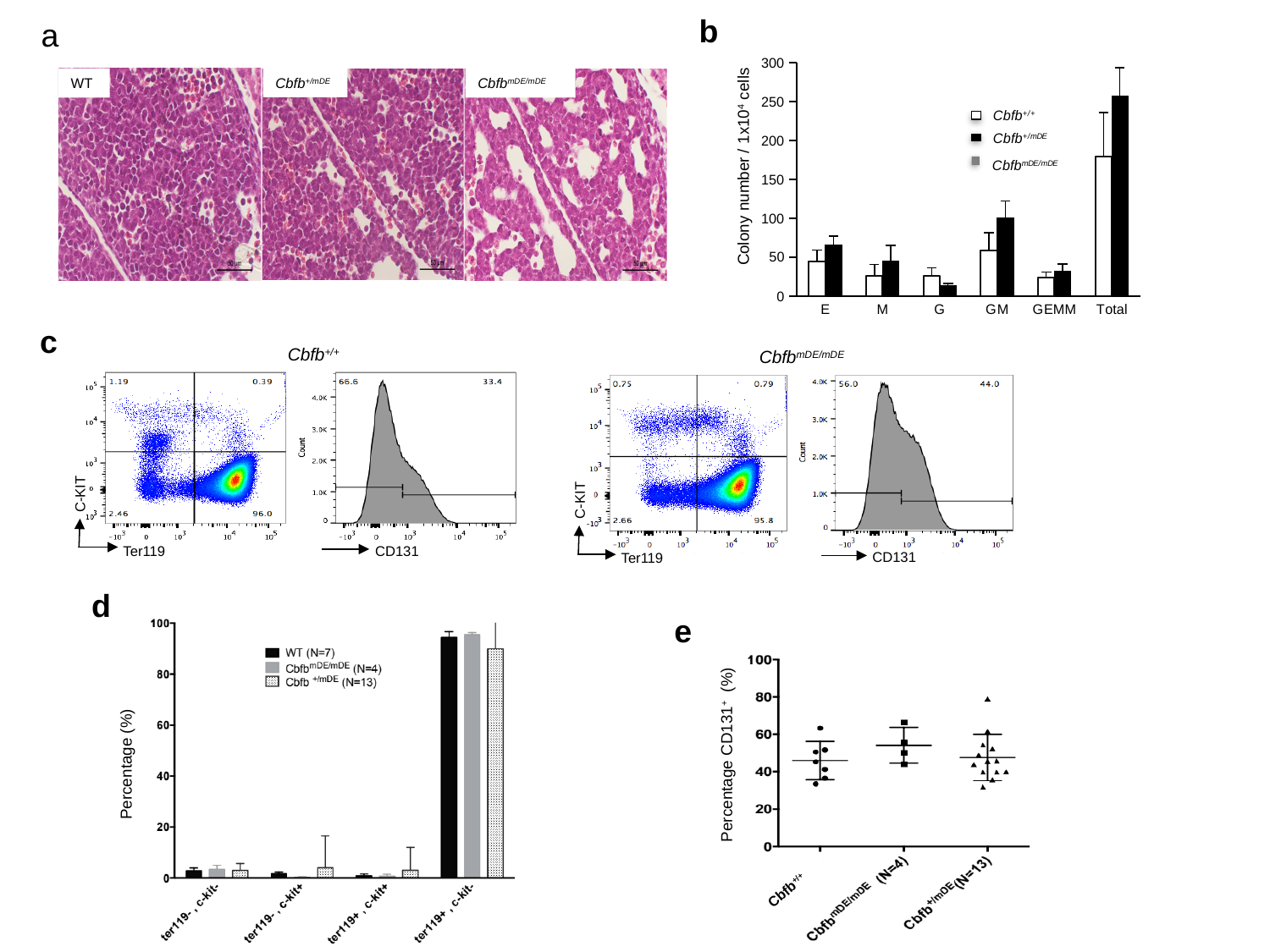
In panel c, what percentage is printed in the right gate of the CD131 histogram for Cbfb+/+? 33.4 In panel b, for the GM category, which series has the larger colony number, Cbfb+/+ or Cbfb+/mDE? Cbfb+/mDE In panel b, how many series does the legend list? 3 In panel b, is the G colony number for Cbfb+/mDE greater or less than 50? less In panel c, what percentage is printed in the right gate of the CD131 histogram for CbfbmDE/mDE? 44.0 In panel b, what kind of chart is shown? bar chart In panel b, which category has the highest colony number? Total In panel c, what value is printed in the lower-right quadrant of the C-KIT vs Ter119 plot for Cbfb+/+? 96.0 In panel b, how many categories are shown on the x axis? 6 In panel d, which category has the highest percentage? ter119+ , c-kit- In panel b, is the Total colony number for Cbfb+/+ greater or less than 150? greater In panel d, how many series does the legend list? 3